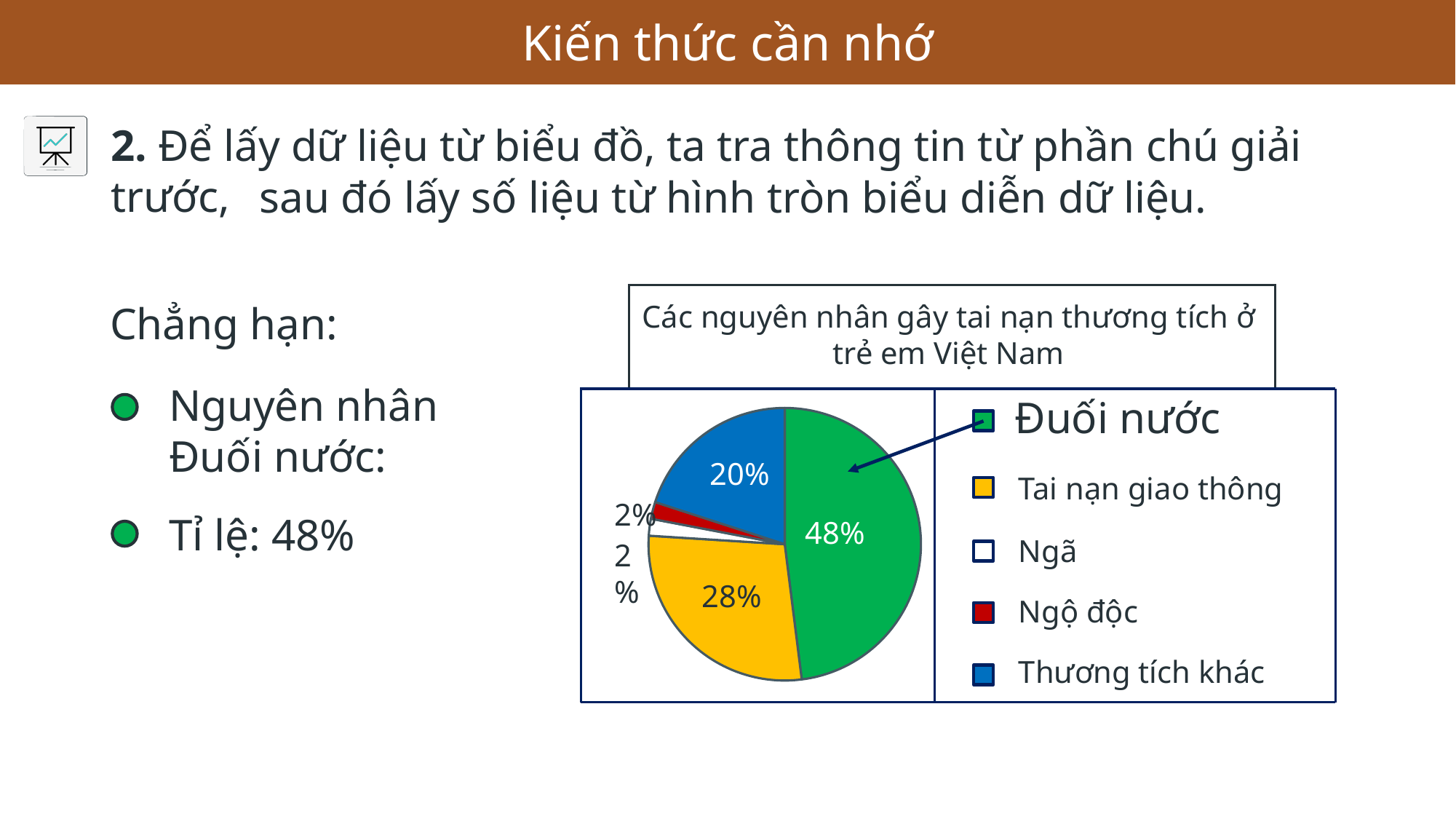
What percentage does the Tai nạn giao thông slice show? 28% What share of the pie chart is Đuối nước? 48% What percentage is shown for Ngộ độc? 2% What is the title of the chart? Các nguyên nhân gây tai nạn thương tích ở trẻ em Việt Nam How many categories does the pie chart show? 5 Which category has the largest slice of the pie chart? Đuối nước What colour is the Đuối nước slice in the pie chart? Green What is the difference in percentage points between Đuối nước and Tai nạn giao thông? 20 Which is larger, the slice for Thương tích khác or the slice for Tai nạn giao thông? Tai nạn giao thông What is the value shown for Thương tích khác? 20% What type of chart is shown on the slide? Pie chart What is the difference in percentage points between Tai nạn giao thông and Thương tích khác? 8